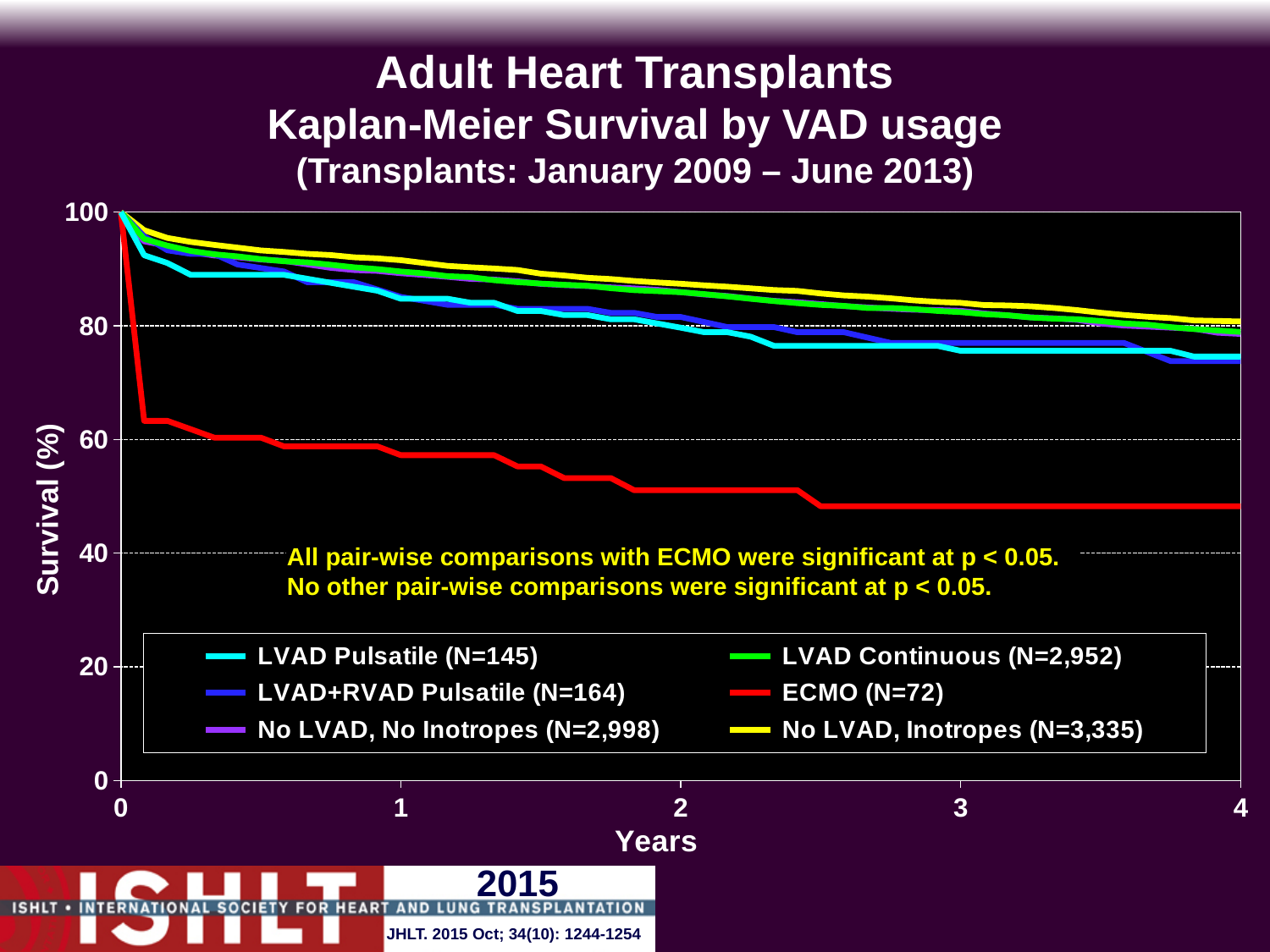
How many series does the legend list? 6 Is the survival value for ECMO at 4 years greater or less than 60? less What is the N for the ECMO group shown in the legend? 72 Is the survival value for LVAD Pulsatile at 4 years greater or less than 80? less What kind of chart is shown on the slide? line chart At 4 years, which group has higher survival: ECMO or LVAD Continuous? LVAD Continuous Do the survival curves rise or fall as years increase? fall What is the label of the y axis? Survival (%) Is the survival value for ECMO at 4 years greater or less than 40? greater Which group has the lowest survival curve throughout the follow-up period? ECMO (N=72)